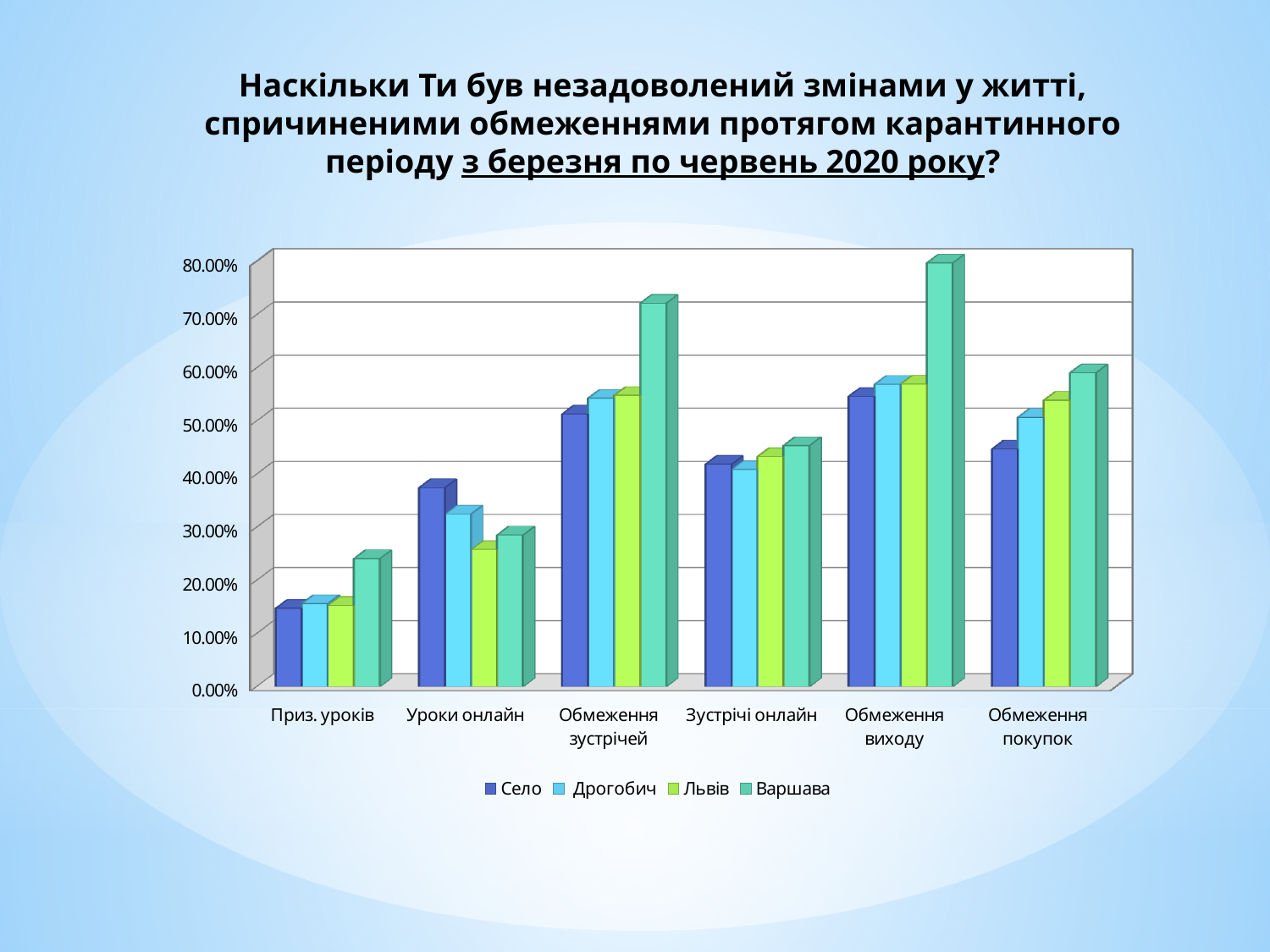
In the Обмеження покупок category, which is larger: the value for Варшава or the value for Село? Варшава How many categories are shown on the x axis? 6 Is the value for Село in the Уроки онлайн category greater or less than 30.00%? greater In the Уроки онлайн category, which series has the highest value? Село For the Варшава series, which category has the lowest value? Приз. уроків Which series is listed first in the legend? Село In the Уроки онлайн category, which is larger: the value for Село or the value for Львів? Село How many series does the legend list? 4 Is the value for Львів in the Приз. уроків category greater or less than 20.00%? less What kind of chart is shown on the slide? bar chart For the Варшава series, which category has the highest value? Обмеження виходу Is the value for Варшава in the Обмеження зустрічей category greater or less than 60.00%? greater